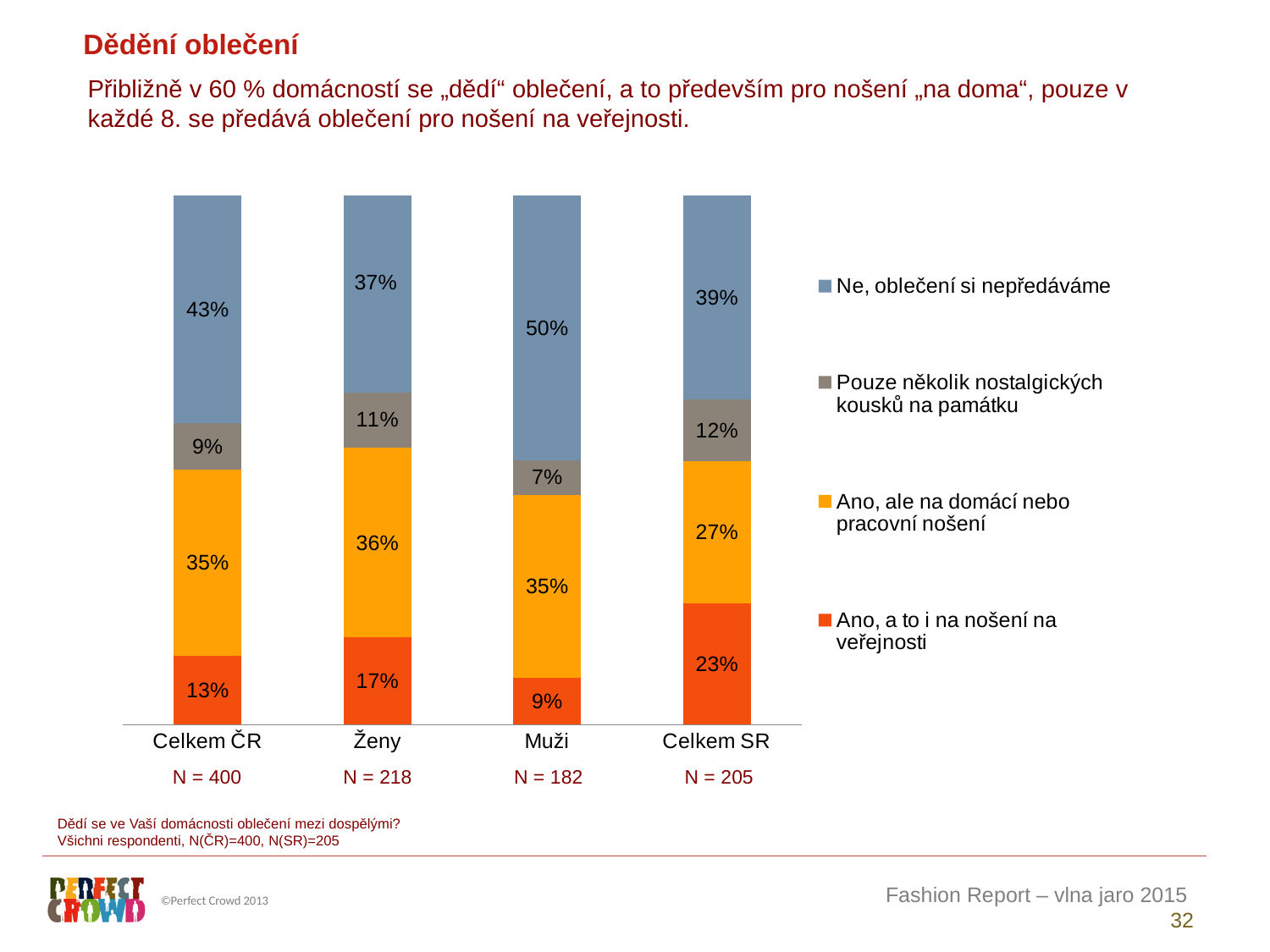
What is the value for "Ano, a to i na nošení na veřejnosti" in the Celkem SR bar? 23% Which is larger for "Pouze několik nostalgických kousků na památku": Celkem ČR or Celkem SR? Celkem SR What is the value for "Ne, oblečení si nepředáváme" in the Muži bar? 50% What sample size (N) is shown under the Muži bar? N = 182 How many series does the legend list? 4 What kind of chart is shown on the slide? Stacked bar chart What is the difference between Ženy and Muži for "Ano, a to i na nošení na veřejnosti"? 8 percentage points What is the total of the Celkem ČR stacked bar? 100% Which category has the lowest value for "Ano, a to i na nošení na veřejnosti"? Muži Which category has the highest value for "Ne, oblečení si nepředáváme"? Muži What is the value for "Ano, ale na domácí nebo pracovní nošení" in the Ženy bar? 36% How many categories are shown on the x axis of the chart? 4